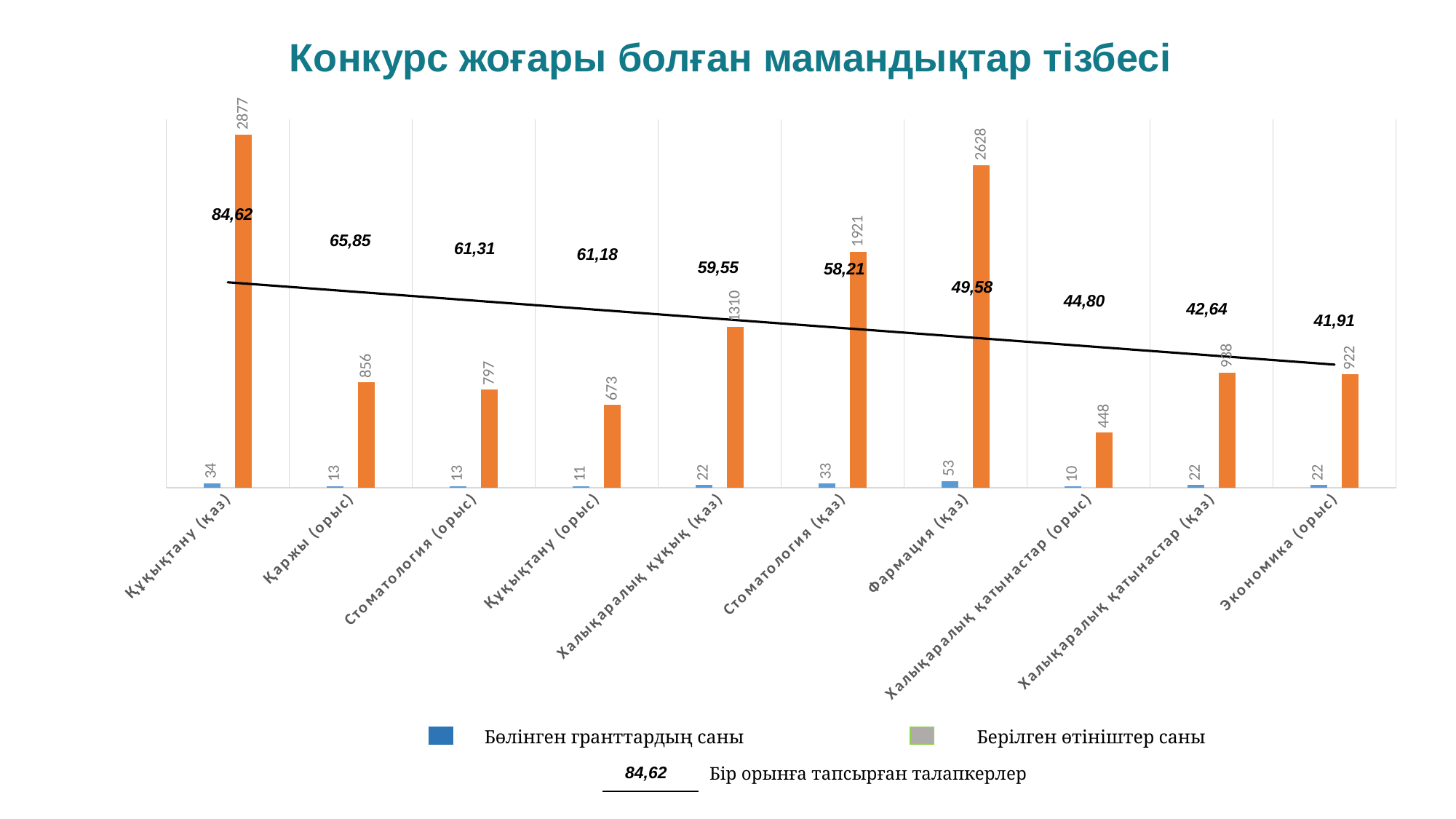
How many categories are shown on the x axis of the chart? 10 Which category has the lowest value of Берілген өтініштер саны? Халықаралық қатынастар (орыс) What is the value of Бөлінген гранттардың саны for Фармация (қаз)? 53 How many series does the legend list? 3 Which category has the highest value of Берілген өтініштер саны? Құқықтану (қаз) Which has a larger value of Бөлінген гранттардың саны: Құқықтану (қаз) or Стоматология (қаз)? Құқықтану (қаз) What is the value of Берілген өтініштер саны for Құқықтану (қаз)? 2877 Does the Бір орынға тапсырған талапкерлер line rise or fall from left to right across the categories? fall What is the value of Бір орынға тапсырған талапкерлер for Стоматология (орыс)? 61,31 What is the difference in Берілген өтініштер саны between Фармация (қаз) and Стоматология (қаз)? 707 What kind of chart is shown on the slide? bar chart What is the title of the chart? Конкурс жоғары болған мамандықтар тізбесі